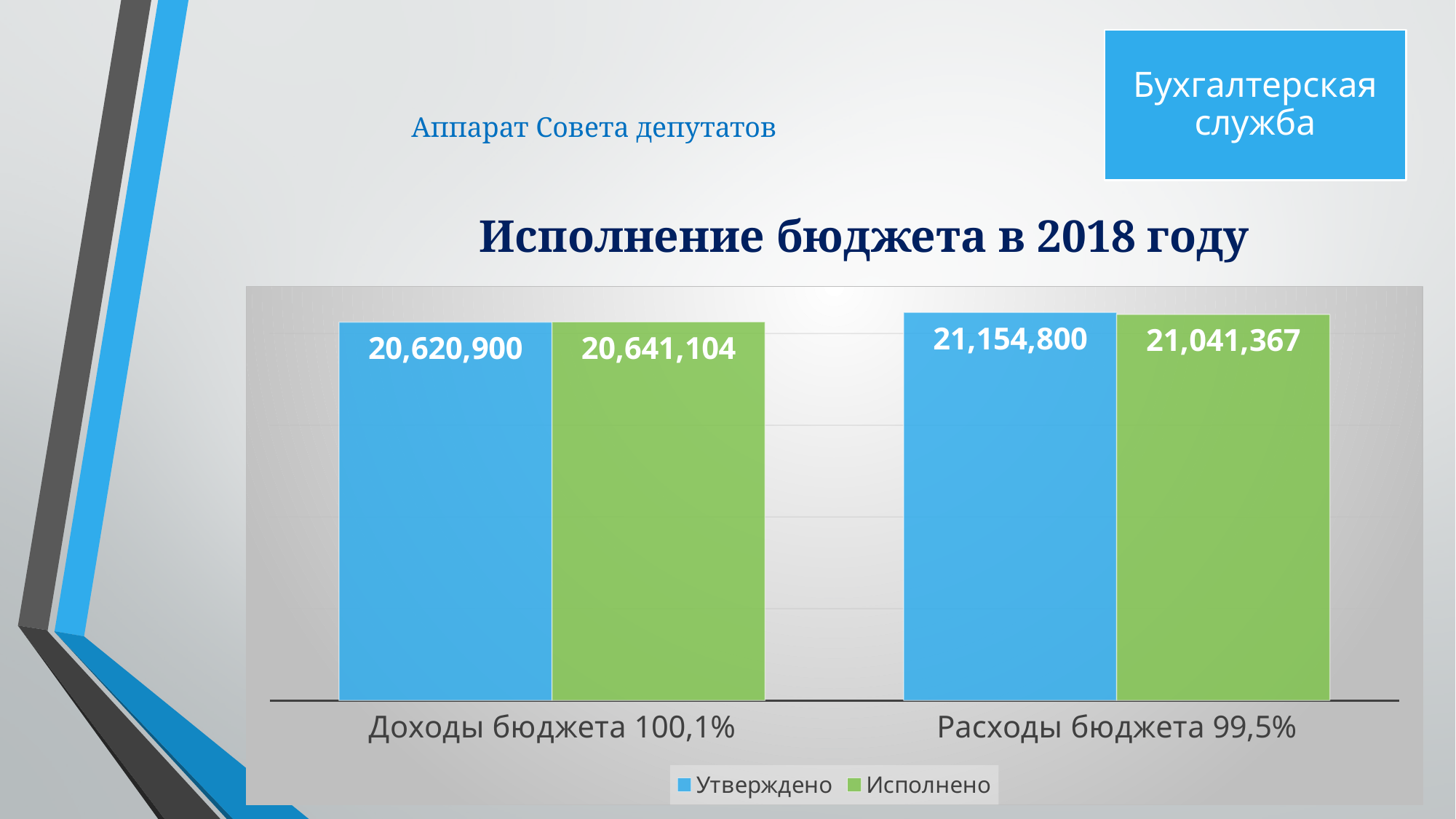
What is the Утверждено value for Расходы бюджета 99,5%? 21,154,800 What is the Исполнено value for Расходы бюджета 99,5%? 21,041,367 Which category has the lowest Исполнено value? Доходы бюджета 100,1% How many series does the legend list? 2 What is the difference between the Исполнено and Утверждено values for Доходы бюджета 100,1%? 20,204 What kind of chart is shown on the slide? Bar chart What is the Утверждено value for Доходы бюджета 100,1%? 20,620,900 What is the Исполнено value for Доходы бюджета 100,1%? 20,641,104 Which category has the highest Утверждено value? Расходы бюджета 99,5% For Расходы бюджета 99,5%, which is larger: Утверждено or Исполнено? Утверждено How many categories are shown on the x axis? 2 What is the difference between the Утверждено and Исполнено values for Расходы бюджета 99,5%? 113,433